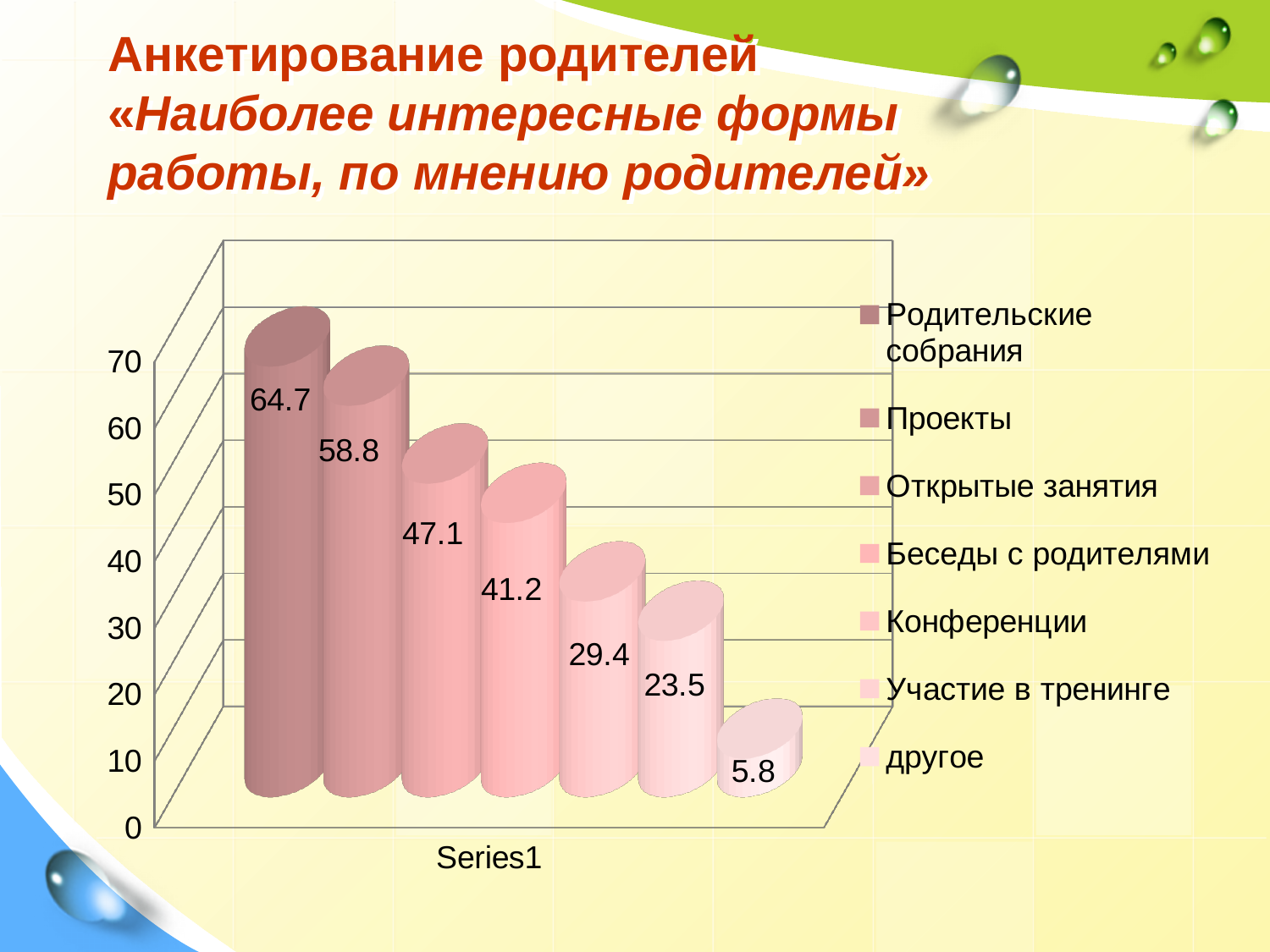
What is the difference between the values for Проекты and Конференции? 29.4 Which is larger, the value for Беседы с родителями or the value for Конференции? Беседы с родителями What value is shown for Открытые занятия? 47.1 What value is shown for Родительские собрания? 64.7 Which legend entry has the highest value? Родительские собрания What kind of chart is shown on the slide? bar chart How many entries does the legend list? 7 Which legend entry has the lowest value? другое What is the label shown on the x axis of the chart? Series1 What is the difference between the values for Родительские собрания and другое? 58.9 Is the value for Проекты greater or less than 50? greater What value is shown for Участие в тренинге? 23.5